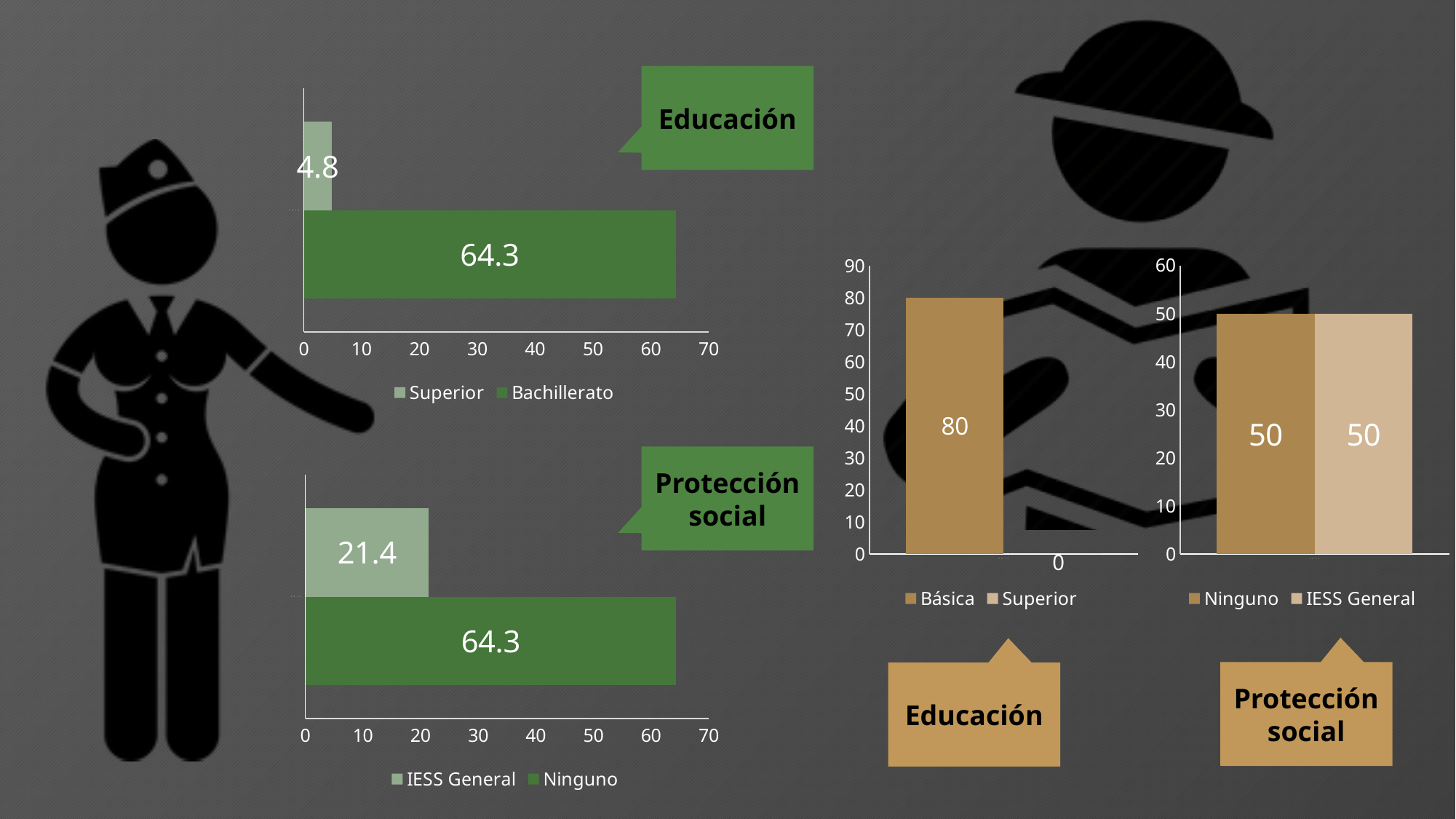
In the bottom-left green Protección social chart, how many series does the legend list? 2 In the brown Protección social chart on the right, what is the value for Ninguno? 50 In the bottom-left green Protección social chart, which series has the higher value, IESS General or Ninguno? Ninguno In the top-left green Educación chart, what is the value for Superior? 4.8 In the brown Educación chart on the right, is the value for Básica greater or less than 70? greater What type of chart is the top-left green Educación chart? Bar chart In the bottom-left green Protección social chart, what is the value for IESS General? 21.4 In the top-left green Educación chart, what is the difference between Bachillerato and Superior? 59.5 In the bottom-left green Protección social chart, what is the difference between Ninguno and IESS General? 42.9 In the brown Educación chart on the right, what is the value for Básica? 80 In the top-left green Educación chart, what is the value for Bachillerato? 64.3 In the brown Protección social chart on the right, what is the value for IESS General? 50